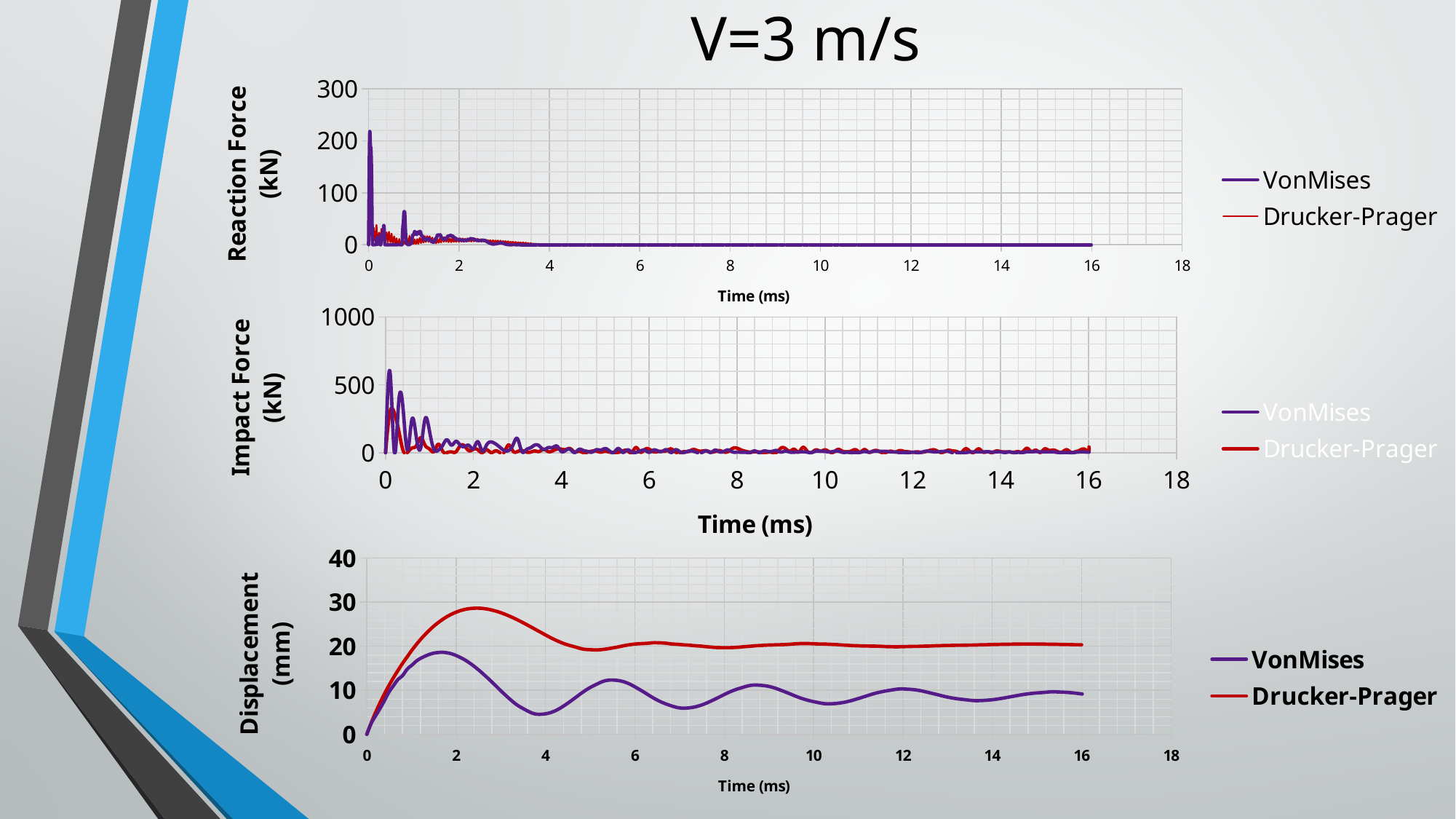
In the Displacement chart, is the peak value of the Drucker-Prager series greater or less than 20? greater In the Impact Force chart, is the peak value of the VonMises series greater or less than 500? greater What kind of chart is the Displacement chart at the bottom of the slide? line chart In the Displacement chart, does the Drucker-Prager series rise or fall between 0 and 2 ms? rise What is the x-axis label of the Impact Force chart? Time (ms) In the Displacement chart, is the peak value of the VonMises series greater or less than 10? greater What is the title shown above the charts on the slide? V=3 m/s How many series does the legend of the Reaction Force chart list? 2 In the Displacement chart, which series reaches the higher peak displacement, VonMises or Drucker-Prager? Drucker-Prager In the Impact Force chart, which series reaches the higher peak force, VonMises or Drucker-Prager? VonMises